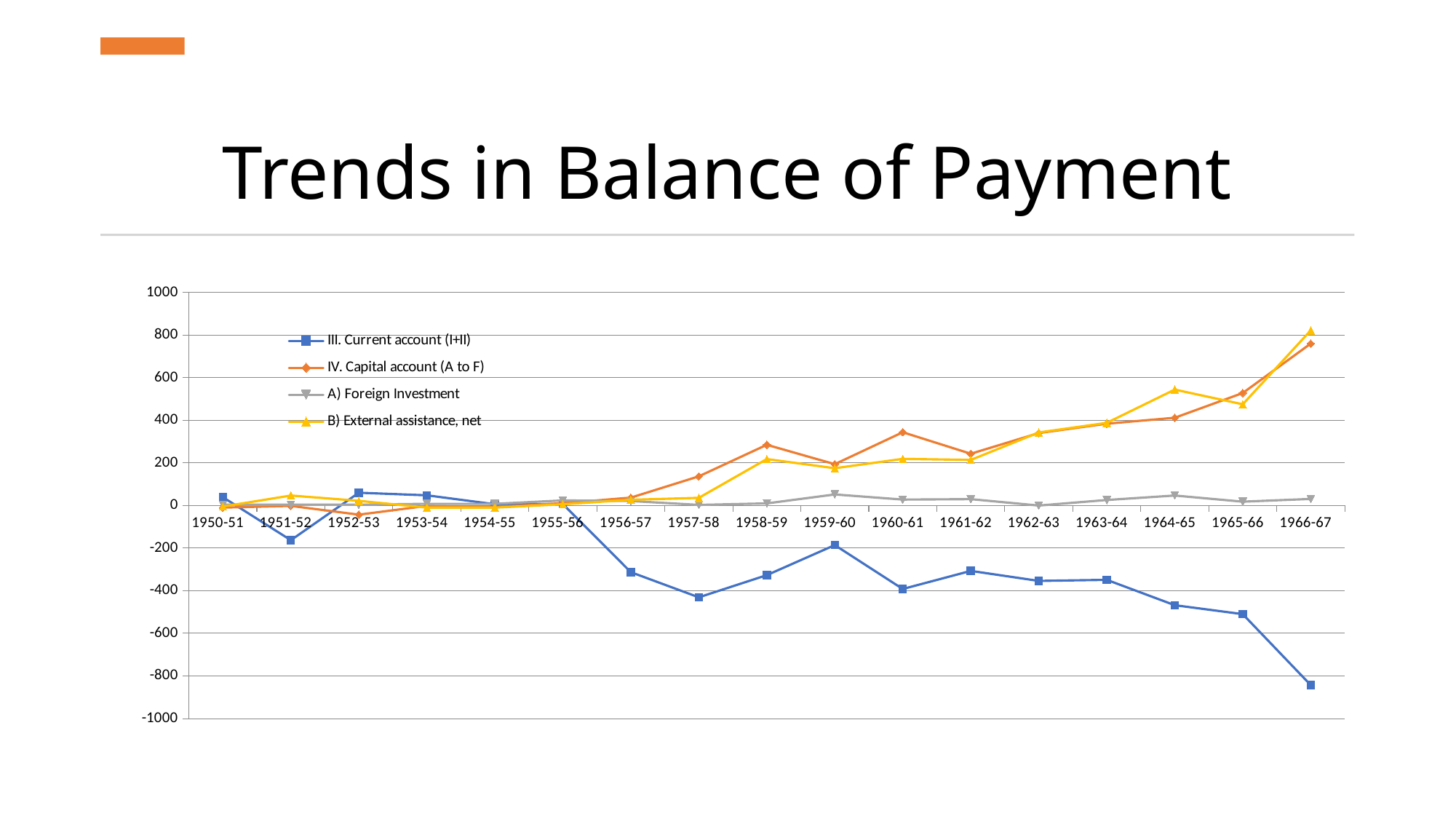
In 1958-59, which is larger: IV. Capital account (A to F) or B) External assistance, net? IV. Capital account (A to F) Is the value for B) External assistance, net in 1966-67 greater or less than 600? greater Is the value for IV. Capital account (A to F) in 1958-59 greater or less than 200? greater How many series does the legend list? 4 Is the value for III. Current account (I+II) in 1966-67 greater or less than -600? less In which year is B) External assistance, net at its highest? 1966-67 What kind of chart is shown on the slide? line chart What is the title of the slide? Trends in Balance of Payment How many years are plotted along the x axis? 17 Does IV. Capital account (A to F) generally rise or fall from 1950-51 to 1966-67? rise In which year is III. Current account (I+II) at its lowest? 1966-67